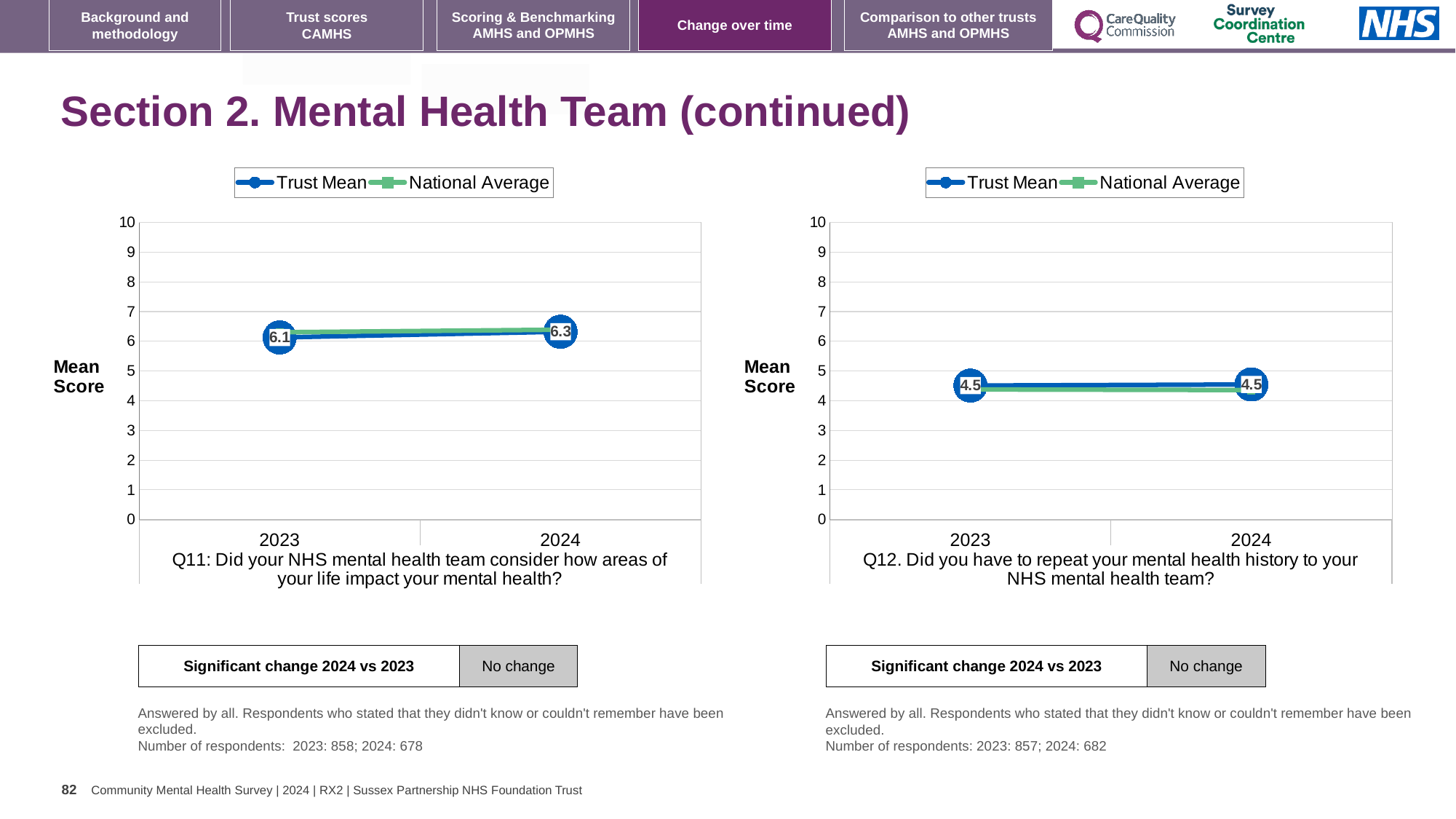
In the left chart (Q11), which year has the higher Trust Mean, 2023 or 2024? 2024 In the left chart (Q11), by how much did the Trust Mean change from 2023 to 2024? 0.2 In the left chart (Q11), is the National Average for 2024 greater or less than 5? greater In the left chart (Q11), does the Trust Mean rise or fall from 2023 to 2024? rise In the left chart (Q11), what is the Trust Mean for 2023? 6.1 In the right chart (Q12), what is the Trust Mean for 2024? 4.5 In the right chart (Q12), does the Trust Mean rise, fall or stay the same from 2023 to 2024? stays the same In the left chart (Q11), what is the Trust Mean for 2024? 6.3 What kind of chart is the right chart (Q12)? line chart How many series does the legend of the right chart (Q12) list? 2 How many years are plotted on the x axis of the left chart (Q11)? 2 In the right chart (Q12), is the Trust Mean for 2023 greater or less than 5? less